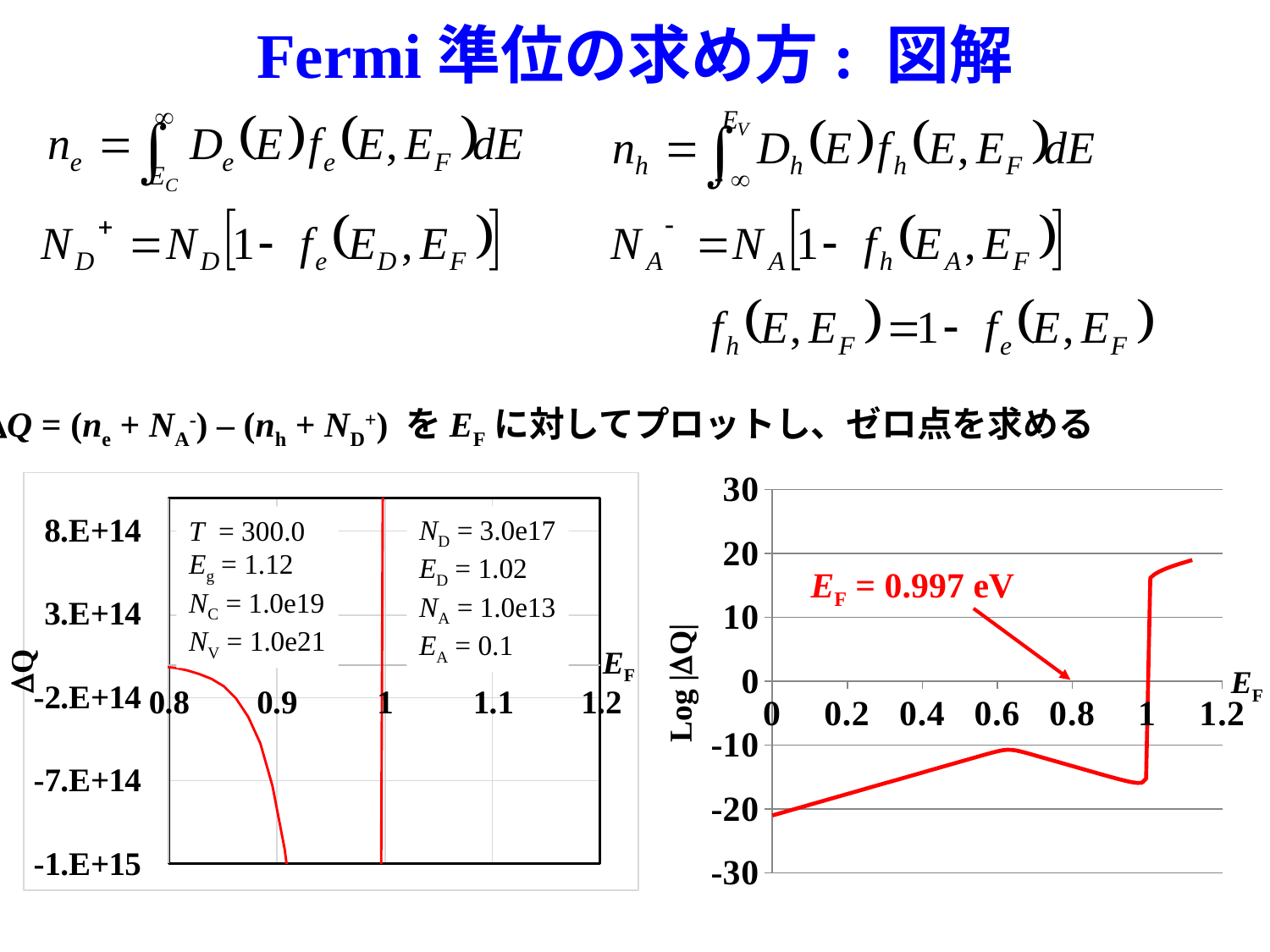
On the right-hand chart, what is the y-axis label? Log |ΔQ| On the left-hand chart, does the curve rise or fall as E_F goes from 0.8 to 0.9? falls On the right-hand chart, is the value of Log |ΔQ| at E_F = 1.1 greater or less than 10? greater On the left-hand chart, is the value of ΔQ at E_F = 0.9 greater or less than 3.E+14? less On the right-hand chart, does the curve rise or fall as E_F goes from 0 to 0.6? rises What kind of chart is the left-hand chart (ΔQ versus E_F)? line chart On the left-hand chart, what is the highest tick value shown on the y-axis? 8.E+14 On the right-hand chart, what is the largest tick value shown on the x-axis? 1.2 What kind of chart is the right-hand chart (Log |ΔQ| versus E_F)? line chart On the right-hand chart, is the value of Log |ΔQ| at E_F = 0.6 greater or less than 0? less On the right-hand chart, what value of E_F is indicated by the red annotation with the arrow? 0.997 eV